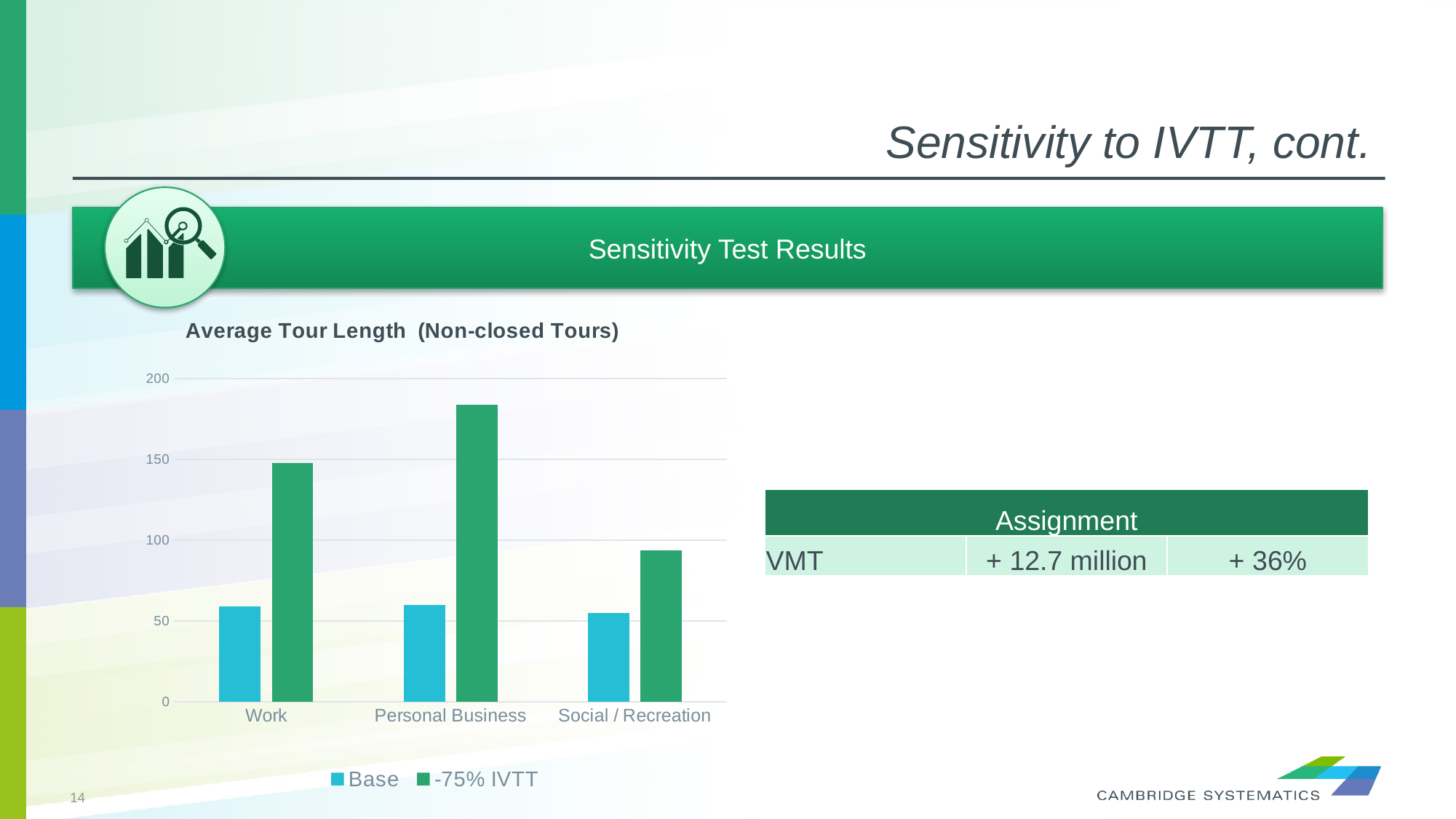
Which category has the lowest -75% IVTT value? Social / Recreation How many categories are shown on the x axis of the chart? 3 How many series does the chart legend list? 2 What are the two series named in the chart legend? Base and -75% IVTT What is the title of the chart? Average Tour Length (Non-closed Tours) Which is larger: the -75% IVTT value for Work or the -75% IVTT value for Social / Recreation? Work Is the -75% IVTT value for Work greater or less than 100? greater Which category has the highest -75% IVTT value? Personal Business Is the Base value for Personal Business greater or less than 100? less What kind of chart is shown on the slide? bar chart Is the -75% IVTT value for Personal Business greater or less than 150? greater